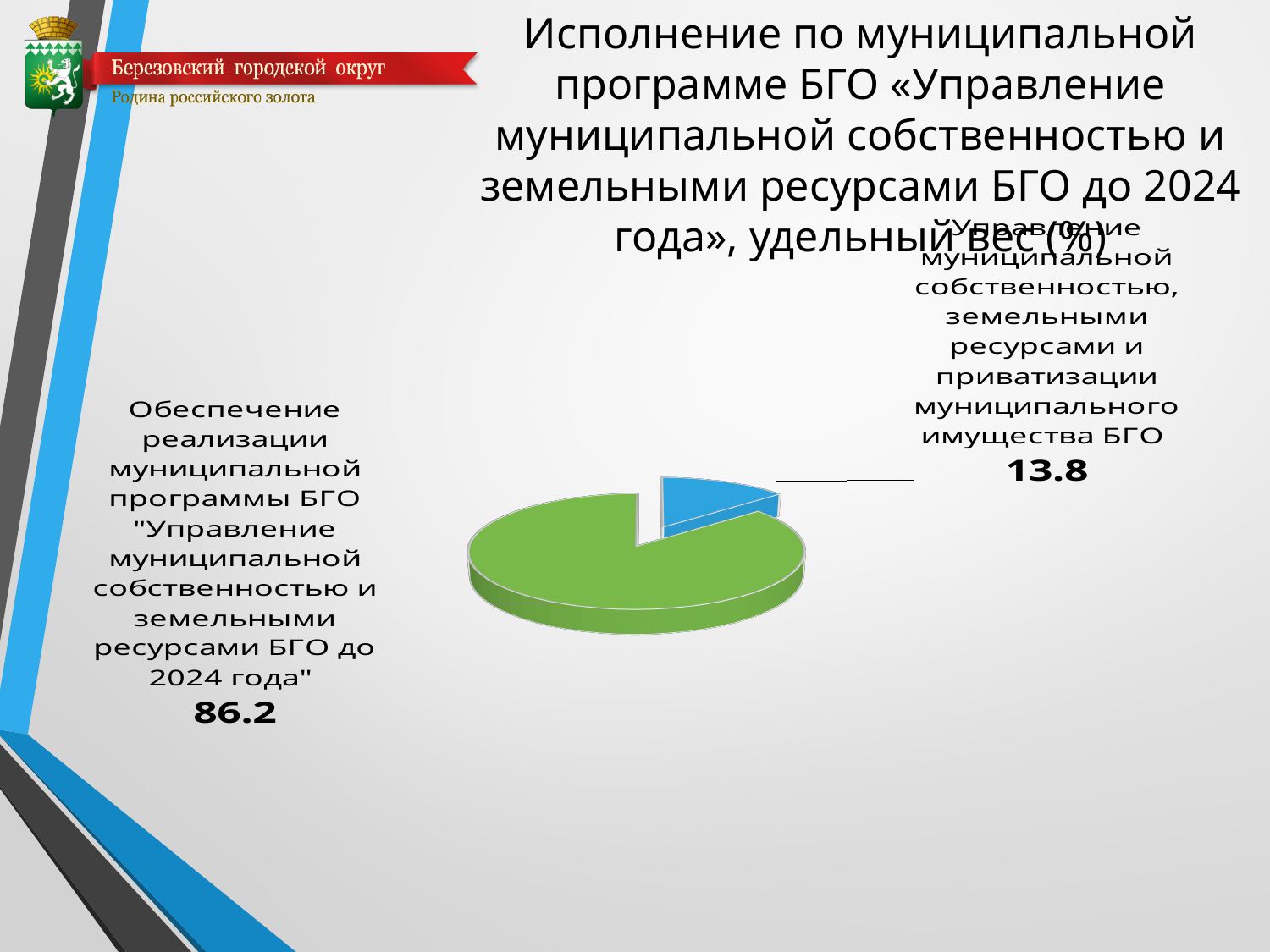
What kind of chart is shown on the slide? Pie chart How many slices does the pie chart have? 2 What is the difference between the two slice values shown on the pie chart? 72.4 Which is larger: the value for "Обеспечение реализации муниципальной программы БГО ..." or the value for "Управление муниципальной собственностью, земельными ресурсами и приватизации муниципального имущества БГО"? Обеспечение реализации муниципальной программы БГО ... Which slice of the pie chart has the smallest value? Управление муниципальной собственностью, земельными ресурсами и приватизации муниципального имущества БГО What value is shown for the slice labelled "Управление муниципальной собственностью, земельными ресурсами и приватизации муниципального имущества БГО"? 13.8 What colour is the slice with the value 13.8? Blue What share of the pie does the green slice represent, according to its data label? 86.2 What value is shown for the slice labelled "Обеспечение реализации муниципальной программы БГО ..."? 86.2 Which slice of the pie chart has the largest value? Обеспечение реализации муниципальной программы БГО "Управление муниципальной собственностью и земельными ресурсами БГО до 2024 года" What unit does the chart title say the values are expressed in? удельный вес (%)